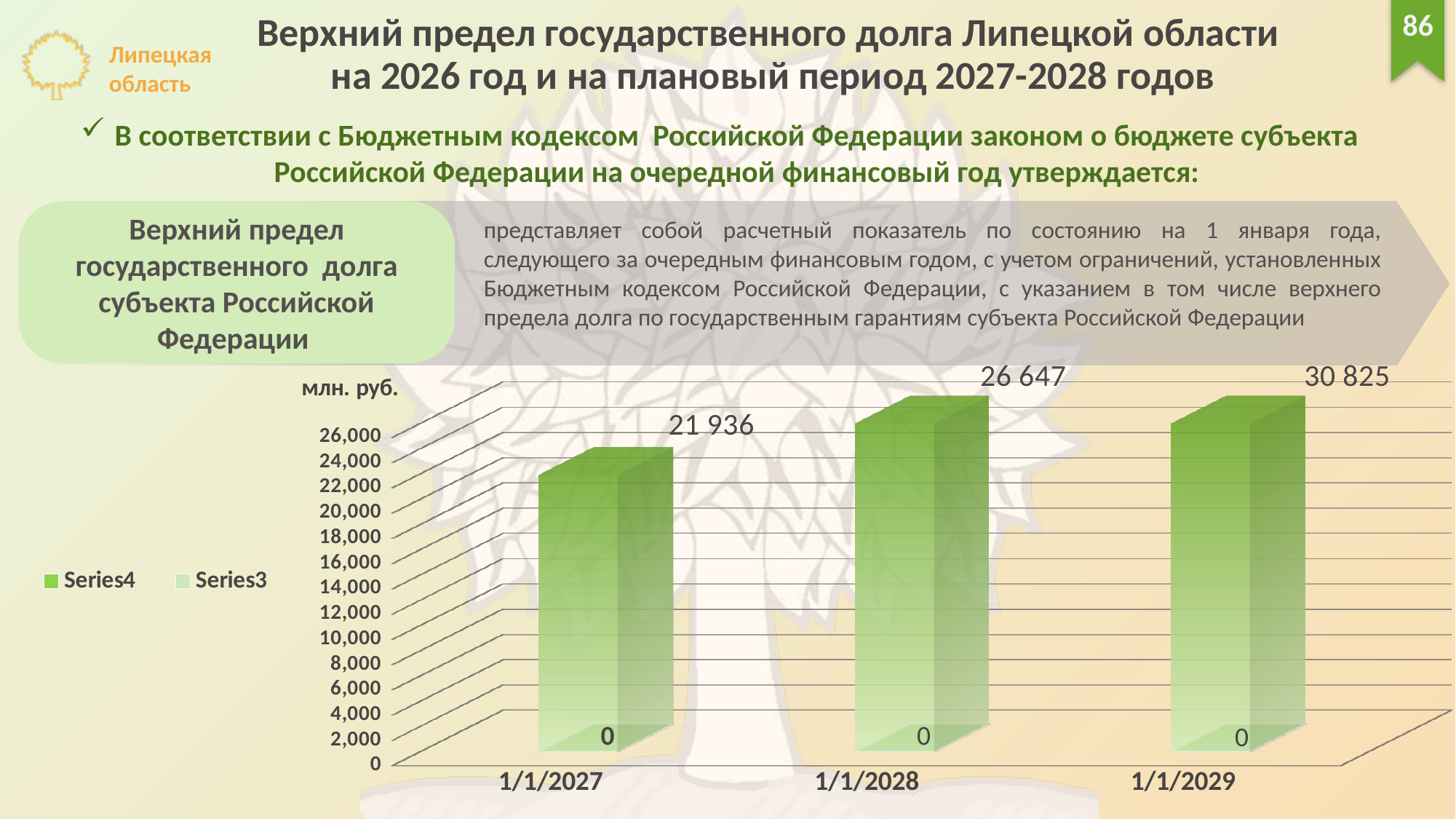
What is the difference between the values for 1/1/2029 and 1/1/2027? 8 889 What is the value shown for 1/1/2028? 26 647 Which date has the highest value? 1/1/2029 How many series does the legend list? 2 How many dates are shown on the x axis? 3 What is the difference between the values for 1/1/2028 and 1/1/2027? 4 711 What kind of chart is shown? bar chart Which date has the lowest non-zero value? 1/1/2027 What is the value shown for 1/1/2029? 30 825 Do the values rise or fall from 1/1/2027 to 1/1/2029? rise What is the value shown for 1/1/2027? 21 936 Which is larger, the value for 1/1/2028 or the value for 1/1/2027? 1/1/2028